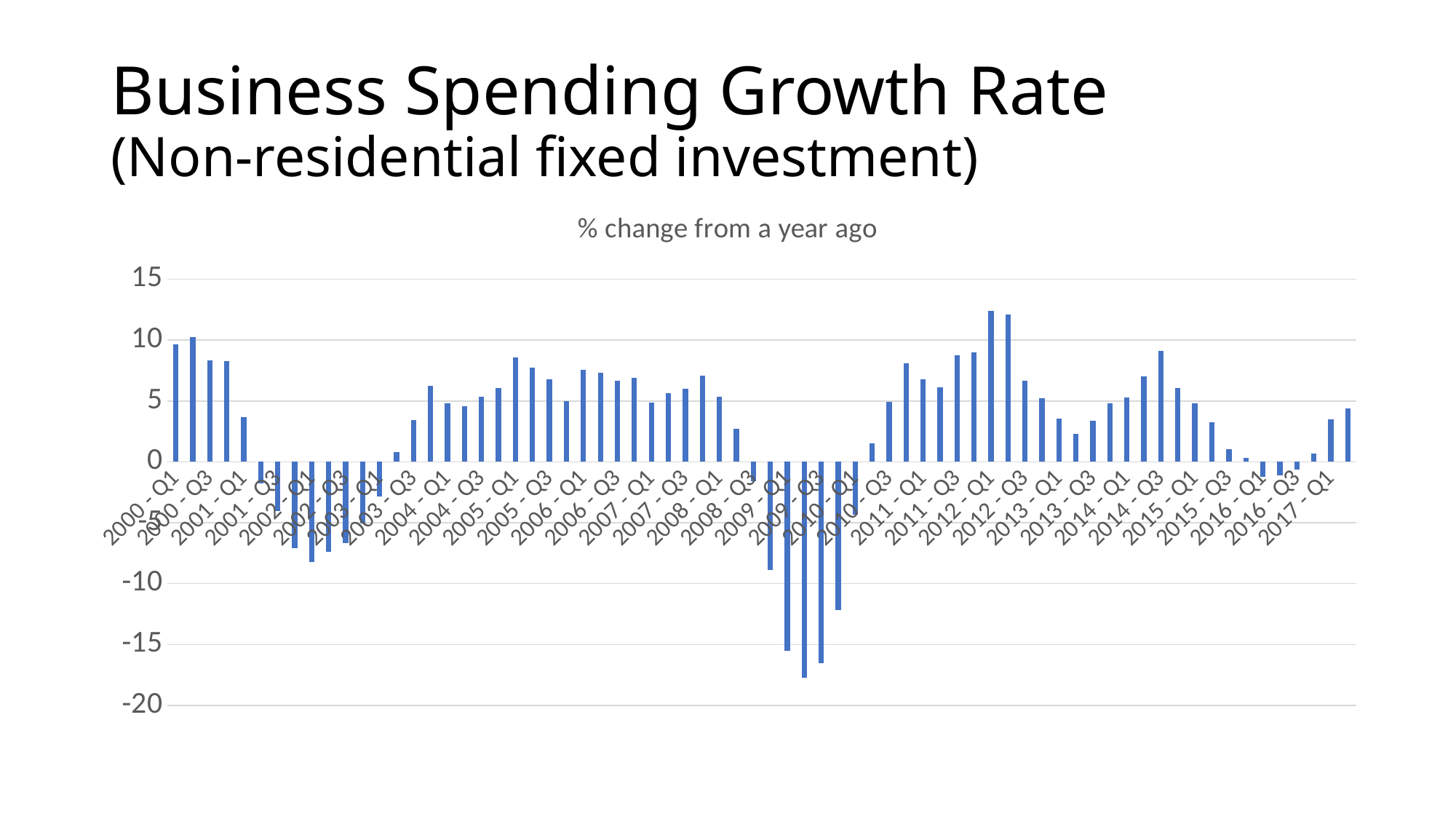
Do the values generally rise or fall from 2012 - Q1 to 2013 - Q1? fall Is the value for 2009 - Q3 greater or less than -15? less Which quarter has the highest value on the chart? 2012 - Q1 Is the value for 2012 - Q1 greater or less than 10? greater Is the value for 2010 - Q1 greater or less than -10? greater What is the title of the chart? % change from a year ago What kind of chart is shown on the slide? bar chart What is the lowest value shown on the vertical axis? -20 Which quarter has the lowest value on the chart? 2009 - Q2 Which is larger, the value for 2000 - Q3 or the value for 2001 - Q1? 2000 - Q3